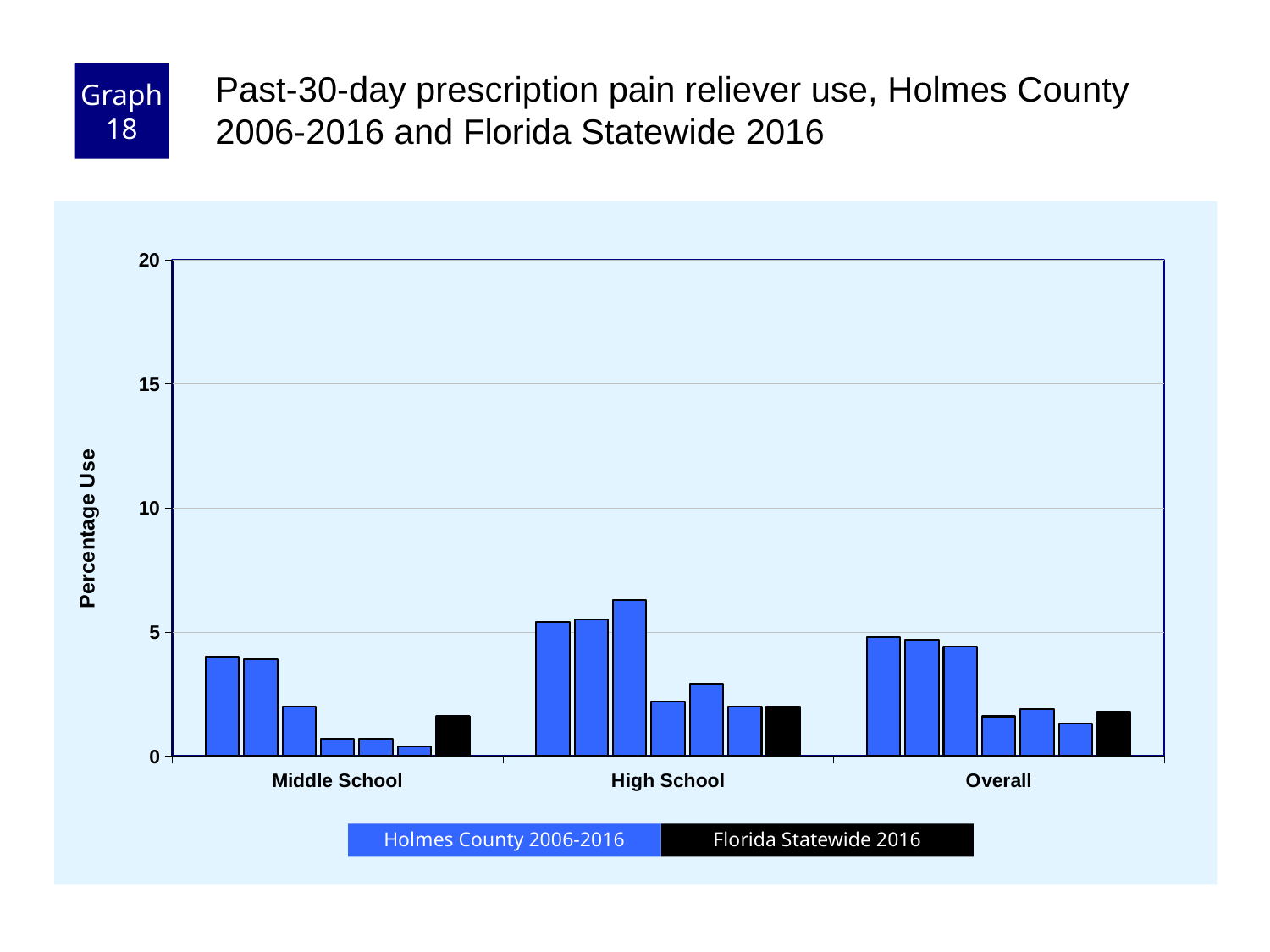
Is the Florida Statewide 2016 value for High School greater or less than 5? less What kind of chart is shown on the slide? bar chart How many series does the legend list? 2 Is the Florida Statewide 2016 value for Middle School greater or less than 5? less Do the Holmes County bars in the Middle School group rise or fall from left to right? fall What are the two series named in the legend? Holmes County 2006-2016 and Florida Statewide 2016 Is the Florida Statewide 2016 value for Overall greater or less than 10? less What is the label on the y axis of the chart? Percentage Use Which category group contains the tallest bar in the chart? High School How many categories are shown on the x axis of the chart? 3 Which category group contains the shortest bar in the chart? Middle School